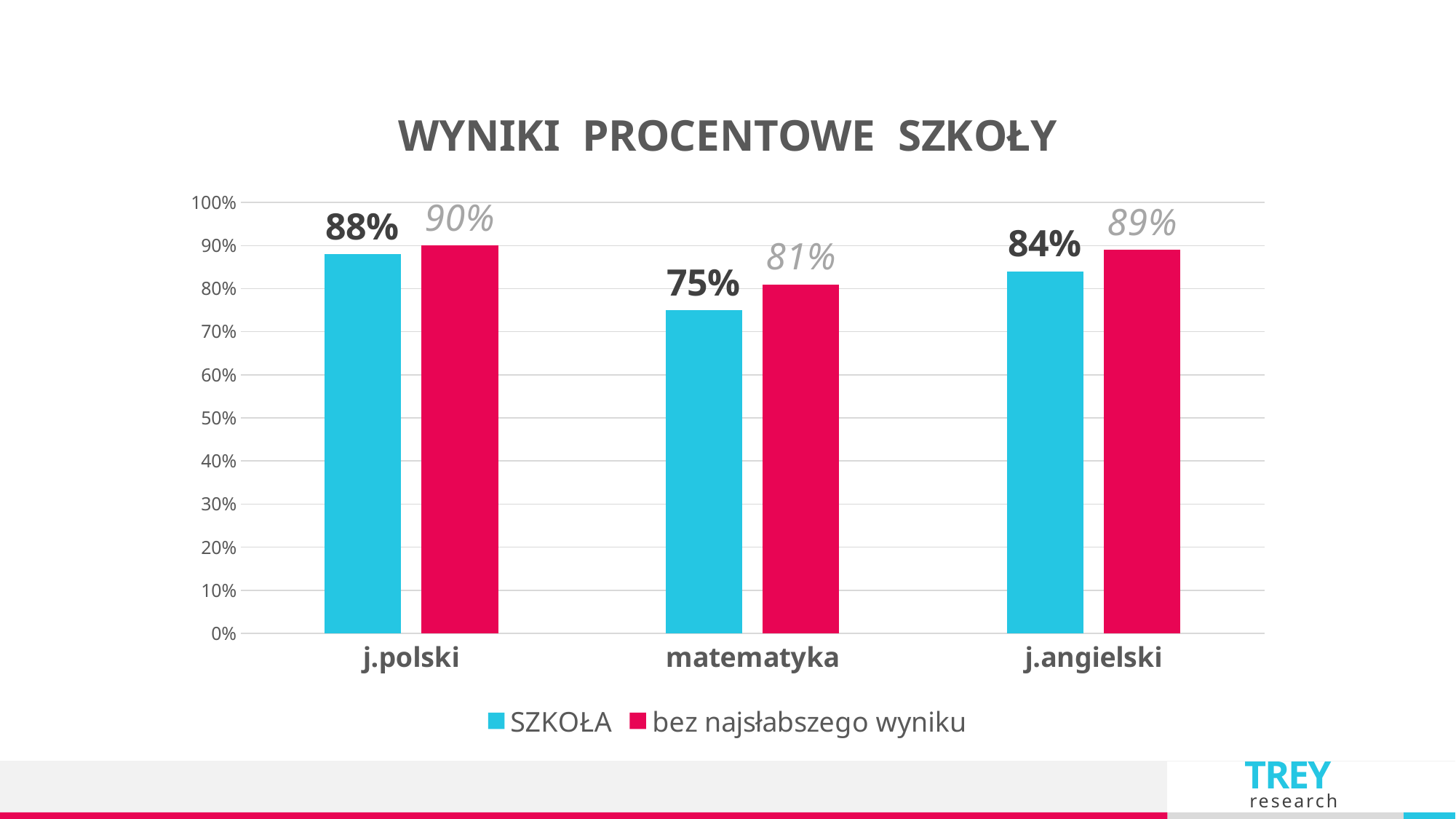
What is the title of the chart? WYNIKI PROCENTOWE SZKOŁY What kind of chart is shown on the slide? bar chart Which subject has the lowest 'bez najsłabszego wyniku' value? matematyka Which is larger for j.angielski: the SZKOŁA value or the 'bez najsłabszego wyniku' value? bez najsłabszego wyniku How many series does the legend list? 2 What is the 'bez najsłabszego wyniku' value for j.angielski? 89% What is the difference between the 'bez najsłabszego wyniku' and SZKOŁA values for matematyka? 6% What is the SZKOŁA value for j.polski? 88% How many subjects are shown on the x axis? 3 Which subject has the highest SZKOŁA value? j.polski What is the SZKOŁA value for matematyka? 75% Is the SZKOŁA value for matematyka greater or less than 80%? less